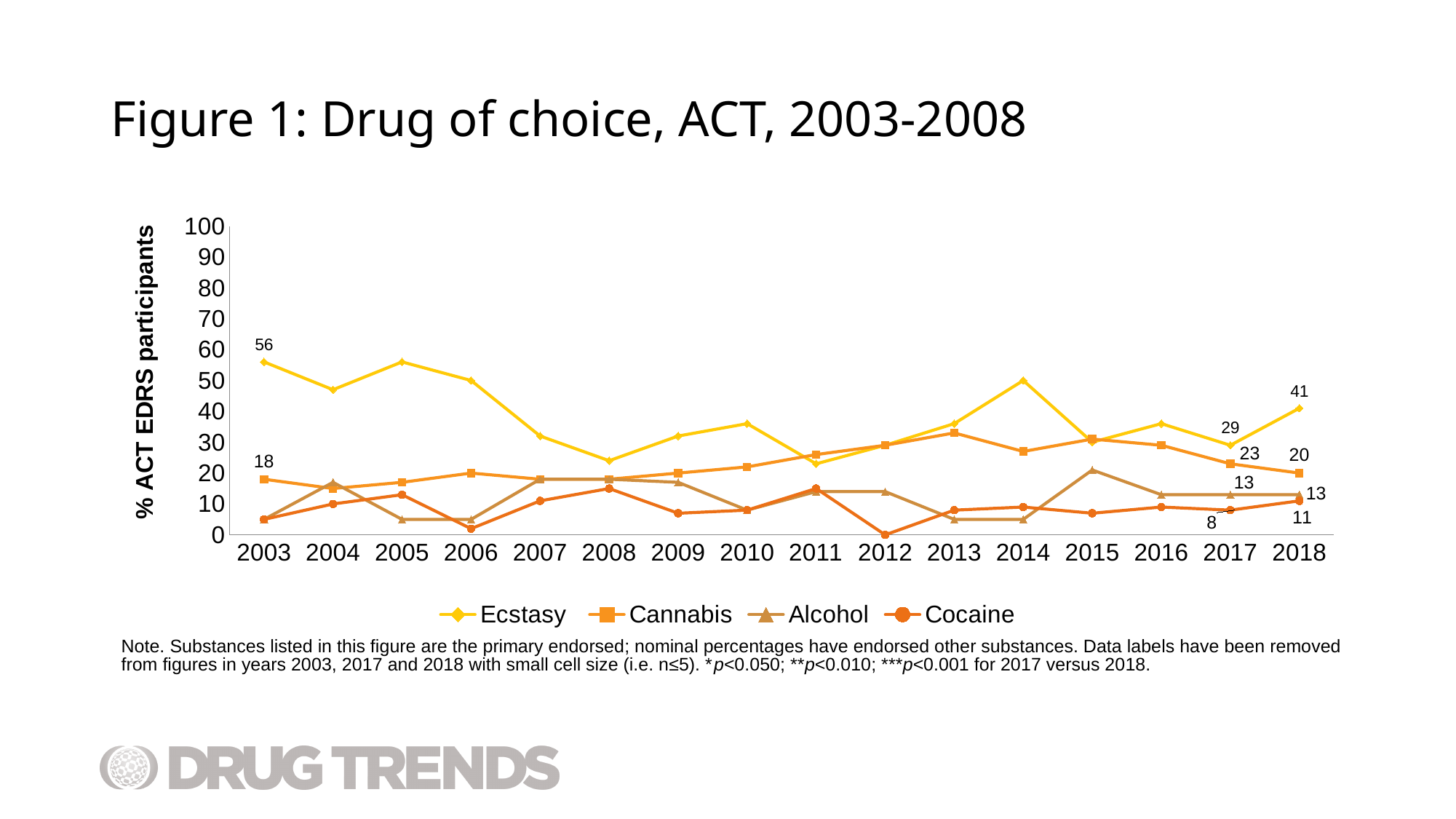
What is the value for Alcohol in 2018? 13 How many years are shown on the x axis? 16 Is the value for Ecstasy in 2014 greater or less than 40? greater What is the difference between the Cannabis values for 2017 and 2018? 3 Which series has the highest value in 2018? Ecstasy What is the value for Ecstasy in 2003? 56 How many series does the legend list? 4 What is the value for Cocaine in 2017? 8 What kind of chart is shown on the slide? line chart What is the value for Cannabis in 2018? 20 Which is larger in 2003, the value for Ecstasy or the value for Cannabis? Ecstasy What is the difference between the Ecstasy values for 2018 and 2017? 12